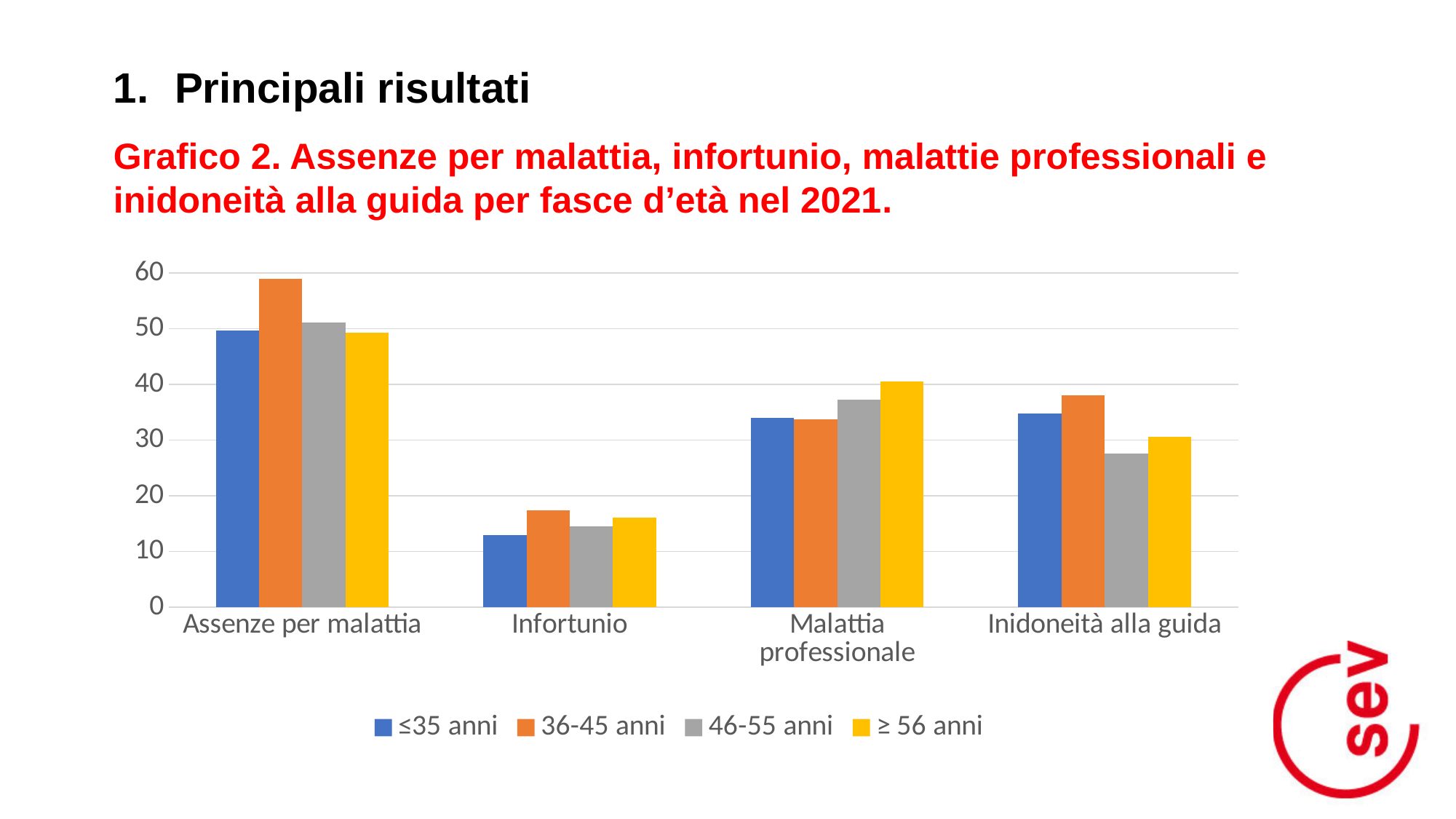
What colour represents the ≥ 56 anni series? yellow Is the value for 36-45 anni in Assenze per malattia greater or less than 50? greater How many categories are shown on the x axis? 4 For Infortunio, which age group has the lowest value? ≤35 anni What kind of chart is shown on the slide? bar chart Is the value for ≤35 anni in Infortunio greater or less than 20? less How many series does the legend list? 4 Which category has the lowest values across all age groups? Infortunio For Assenze per malattia, which age group has the highest value? 36-45 anni Which is larger for ≥ 56 anni: Malattia professionale or Inidoneità alla guida? Malattia professionale For Inidoneità alla guida, which age group has the lowest value? 46-55 anni For Malattia professionale, which age group has the highest value? ≥ 56 anni